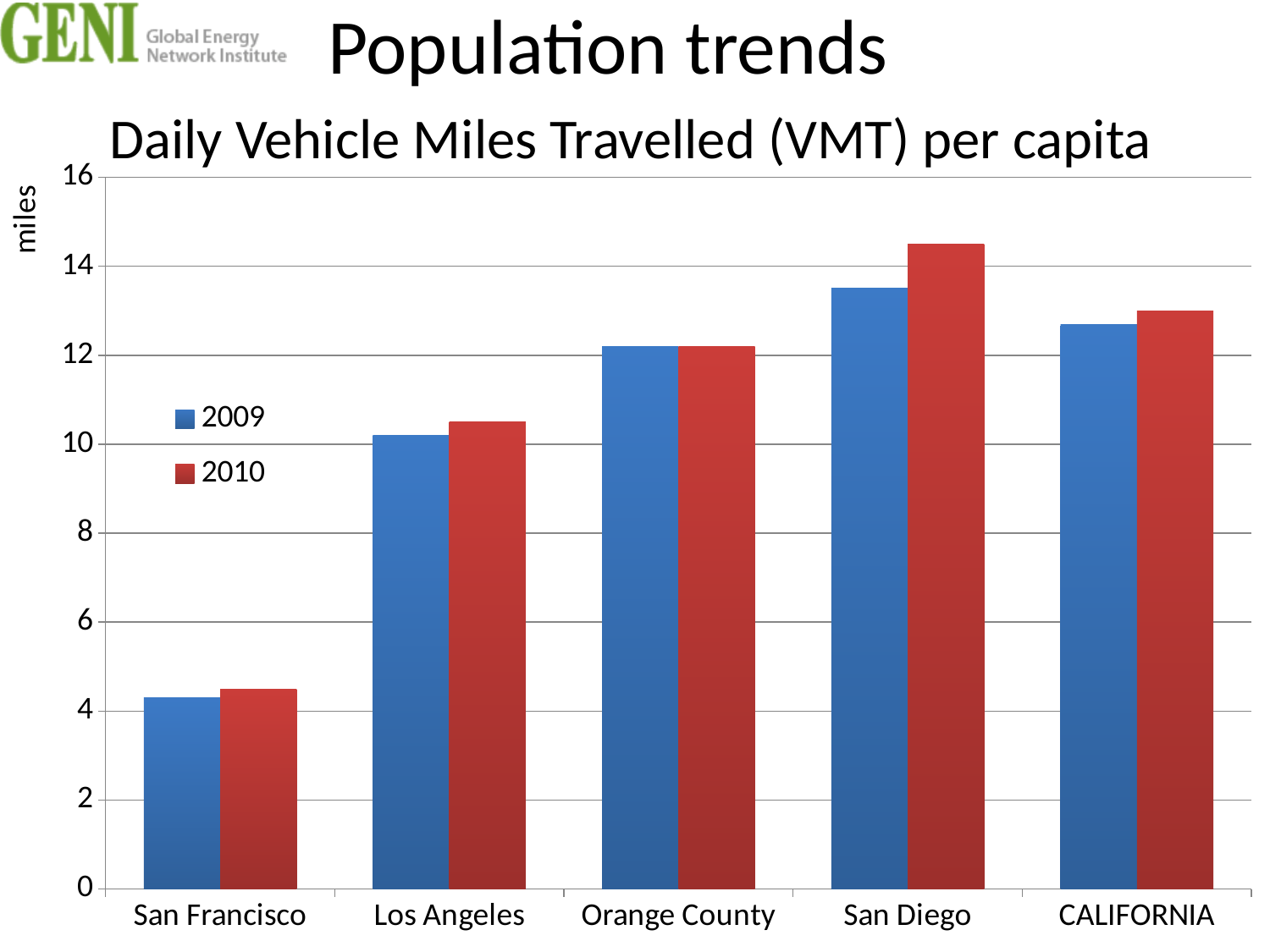
Which is larger for 2010: San Diego or CALIFORNIA? San Diego Is the 2009 value for Los Angeles greater or less than 8? greater How many series does the legend list? 2 Is the 2009 value for San Francisco greater or less than 6? less Is the 2010 value for San Diego greater or less than 14? greater Which category has the lowest value for 2009? San Francisco Which category has the highest value for 2010? San Diego What is the label on the y axis of the chart? miles What kind of chart is shown on the slide? bar chart What is the title of the chart? Daily Vehicle Miles Travelled (VMT) per capita How many categories are shown on the x axis of the chart? 5